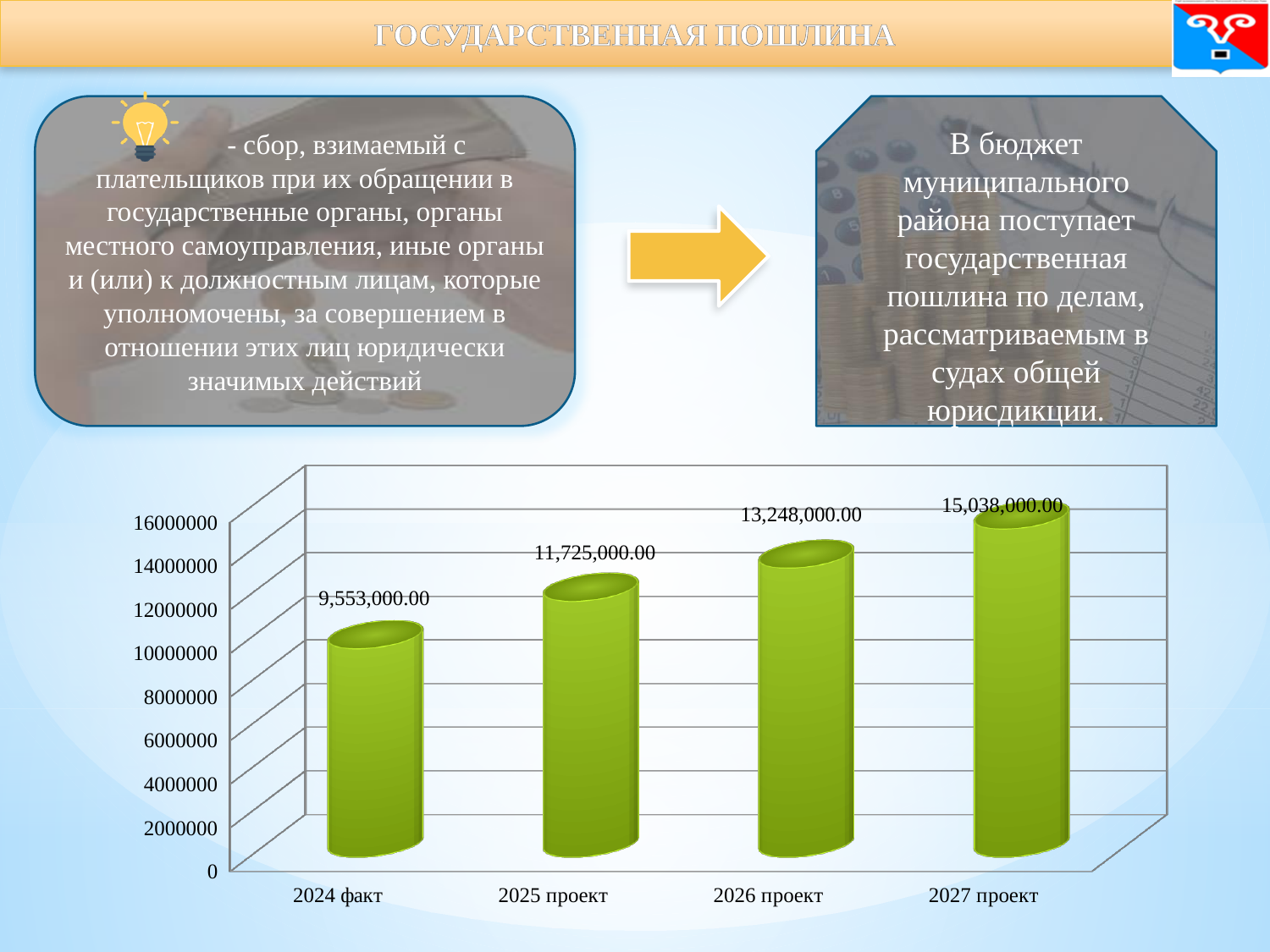
What is the value for 2026 проект? 13,248,000.00 What is the value for 2025 проект? 11,725,000.00 What is the value for 2027 проект? 15,038,000.00 What is the value for 2024 факт? 9,553,000.00 What kind of chart is shown on the slide? bar chart How many categories are shown on the x axis? 4 Which category has the highest value? 2027 проект What is the difference between the values for 2026 проект and 2025 проект? 1,523,000.00 Which category has the lowest value? 2024 факт Which is larger, the value for 2025 проект or the value for 2026 проект? 2026 проект What is the difference between the values for 2027 проект and 2024 факт? 5,485,000.00 Is the value for 2027 проект greater or less than 14000000? greater